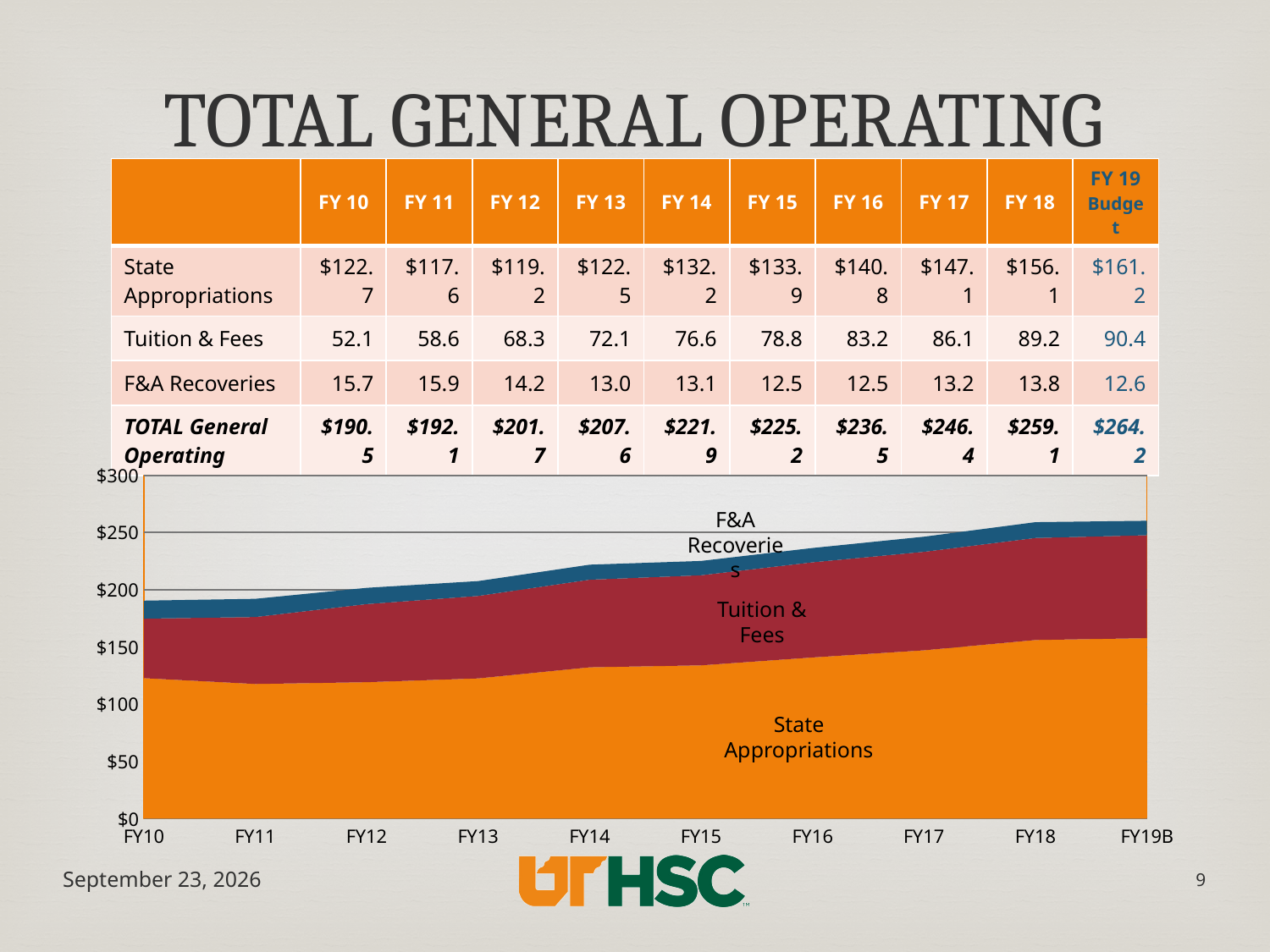
What is the difference between Tuition & Fees in FY 19 Budget and FY 10? 38.3 Is the total general operating value for FY16 greater or less than $200? greater In which fiscal year is State Appropriations lowest? FY 11 What is the Tuition & Fees value for FY 18? 89.2 Which series forms the bottom (largest) layer of the stacked area chart? State Appropriations Does the total general operating amount rise or fall from FY10 to FY19B? rise How many fiscal years are plotted along the x axis of the chart? 10 What is the State Appropriations value for FY 14? $132.2 What is the TOTAL General Operating value for the FY 19 Budget? $264.2 What kind of chart is shown on the slide? stacked area chart In which fiscal year is F&A Recoveries highest? FY 11 How many series are stacked in the chart? 3